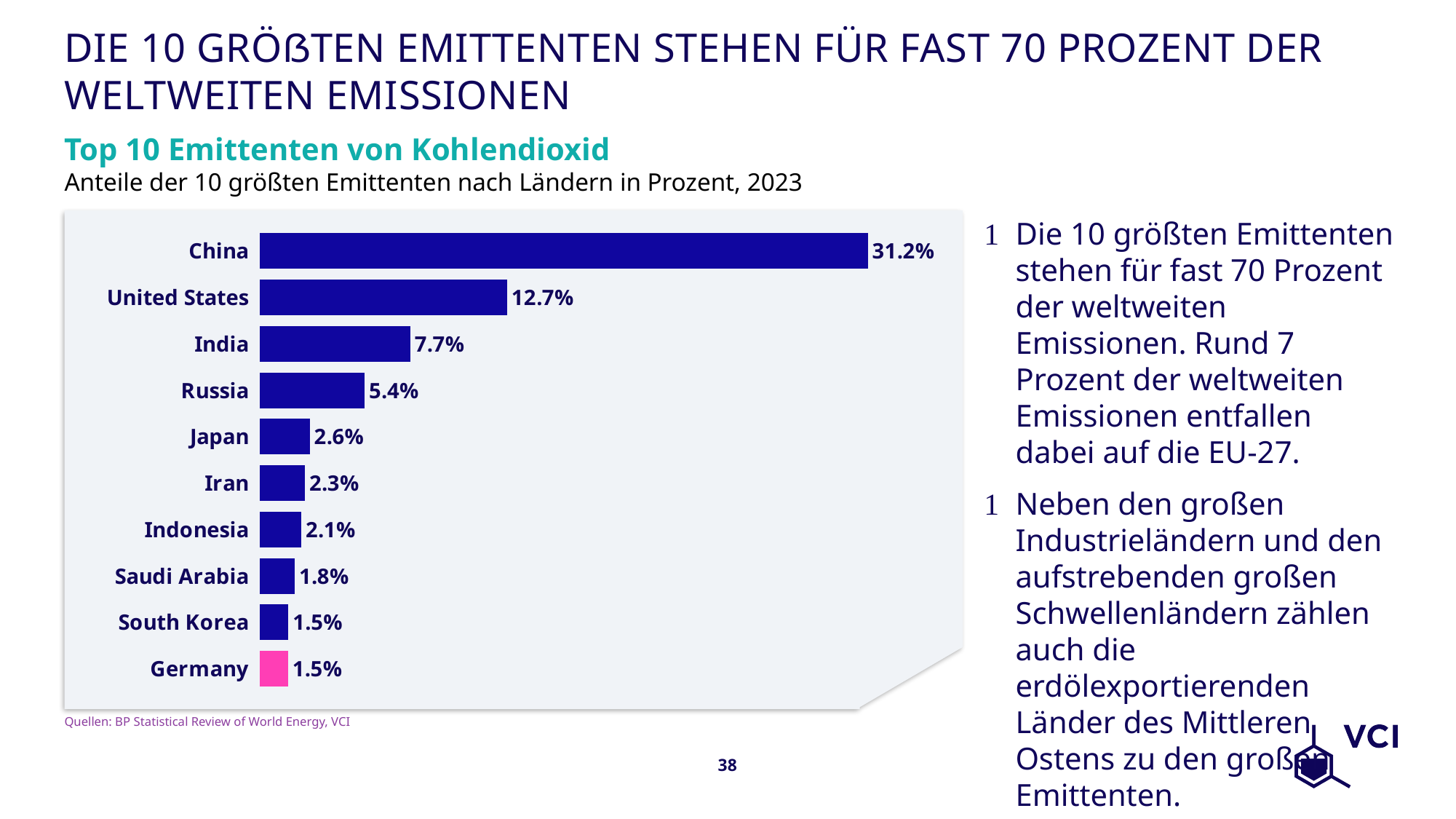
What is the value for China? 31.2% What is the title of the chart? Top 10 Emittenten von Kohlendioxid What is the difference between the values for China and the United States? 18.5% How many countries are shown in the chart? 10 What kind of chart is shown on the slide? Bar chart Which country has the highest share? China What is the difference between the values for Russia and Japan? 2.8% What is the value for Saudi Arabia? 1.8% What is the value for India? 7.7% Which is larger, the value for Iran or the value for Indonesia? Iran Which country's bar is shown in a different colour (pink) from the others? Germany Which is larger, the value for the United States or the value for India? United States